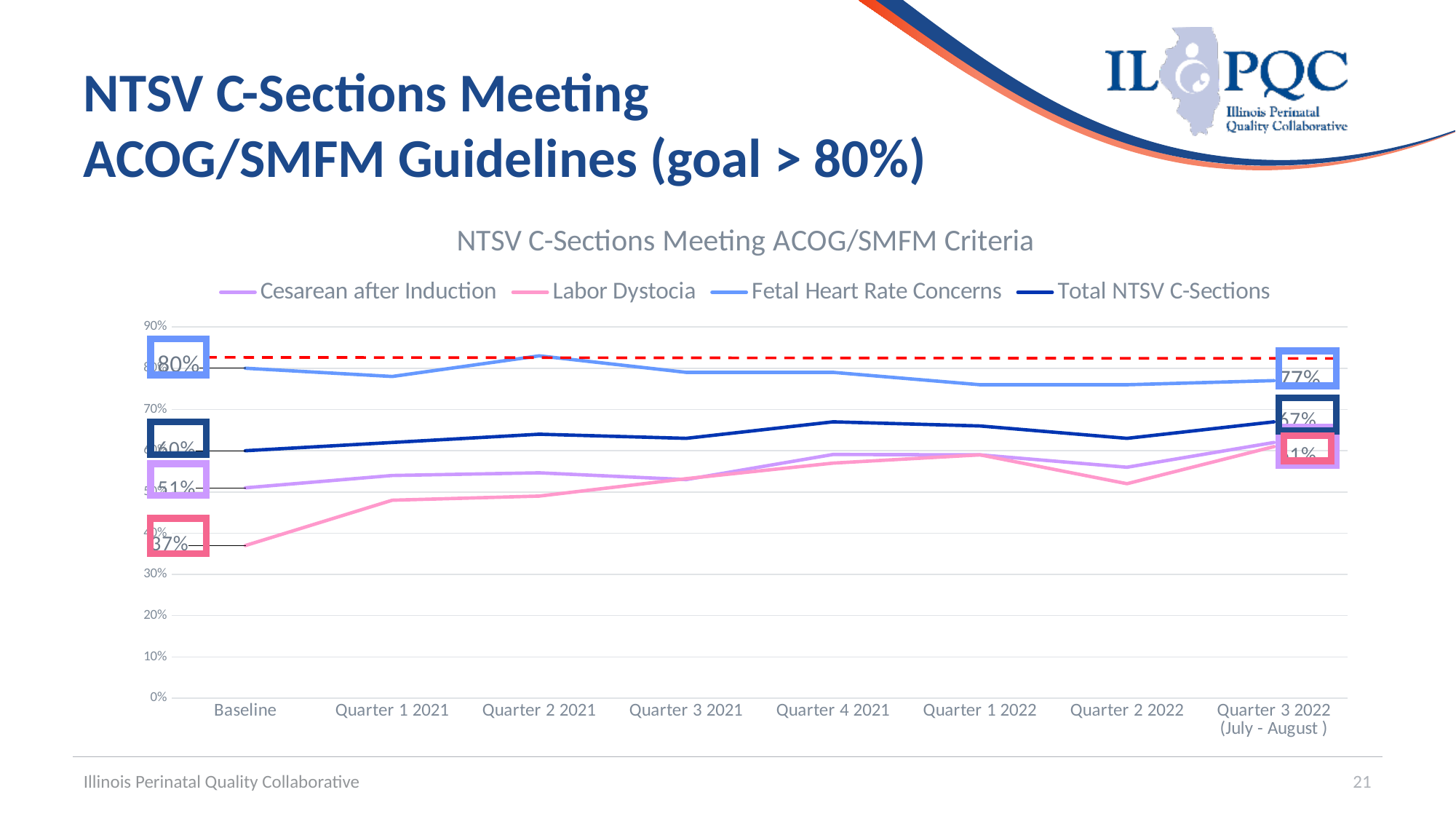
Is the value for Labor Dystocia in Quarter 1 2021 greater or less than 50%? less What is the Baseline value for Labor Dystocia? 37% What does the red dashed horizontal line on the chart represent? The 80% goal Which series has the lowest value at Baseline? Labor Dystocia What type of chart is shown on the slide? Line chart What is the Baseline value for Cesarean after Induction? 51% By how many percentage points did Total NTSV C-Sections change from Baseline to Quarter 3 2022? 7 percentage points What is the value for Total NTSV C-Sections in Quarter 3 2022 (July - August)? 67% What is the Baseline value for Fetal Heart Rate Concerns? 80% How many time periods are shown along the x axis? 8 What is the Baseline value for Total NTSV C-Sections? 60% How many series does the legend list? 4